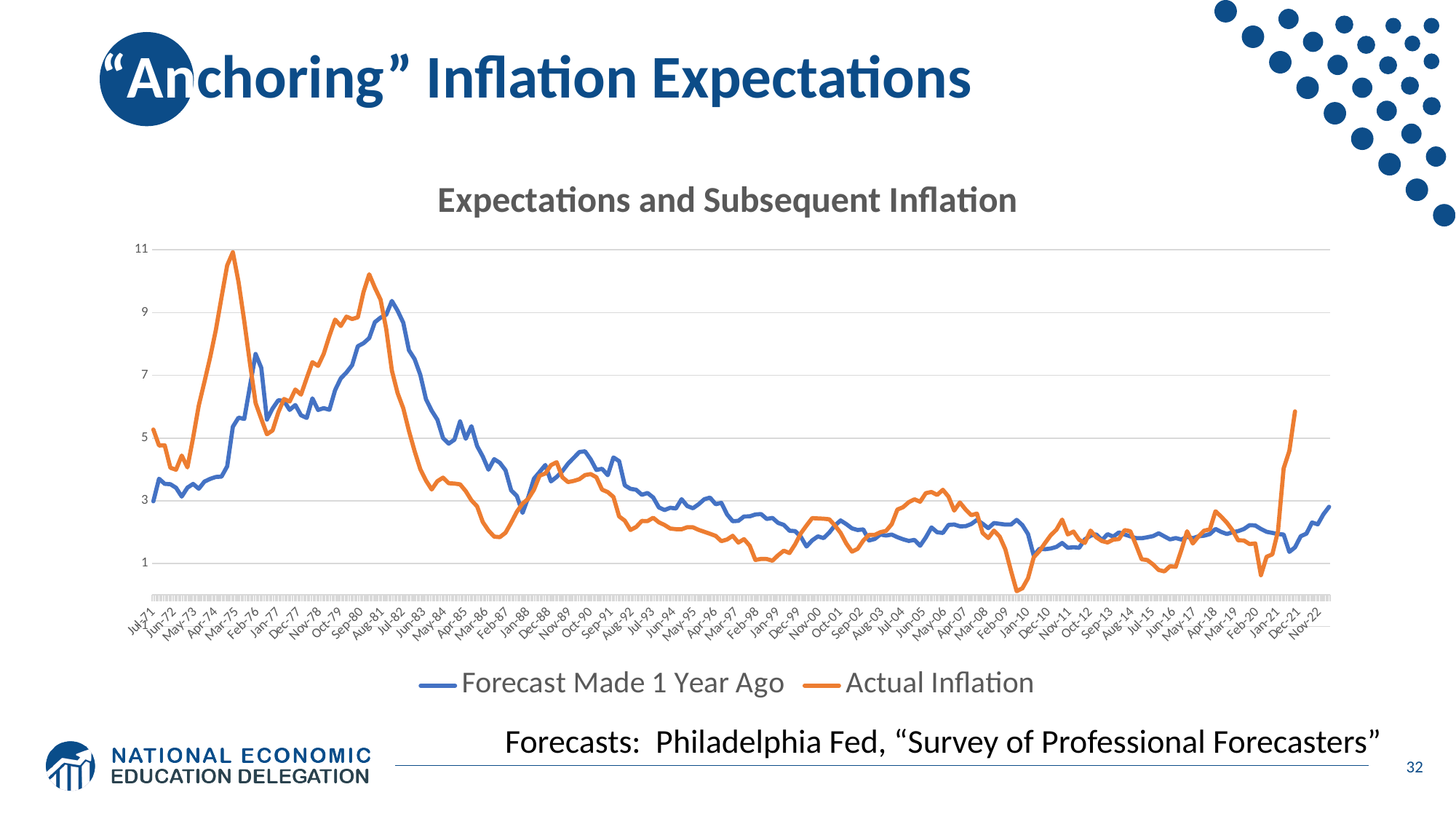
What kind of chart is shown on the slide? line chart How many series does the chart's legend list? 2 What is the title of the chart? Expectations and Subsequent Inflation Is the value of Actual Inflation at Dec-21 greater or less than 5? greater Is the peak value of Forecast Made 1 Year Ago around Jul-82 greater or less than 7? greater Around Mar-75, which series is higher: Forecast Made 1 Year Ago or Actual Inflation? Actual Inflation Is the value of Actual Inflation around Jan-10 greater or less than 1? less Around Jul-82, which series is higher: Forecast Made 1 Year Ago or Actual Inflation? Forecast Made 1 Year Ago Does Actual Inflation rise or fall between Mar-75 and Feb-76? fall Which series reaches the highest peak on the chart? Actual Inflation Which series is drawn in orange? Actual Inflation